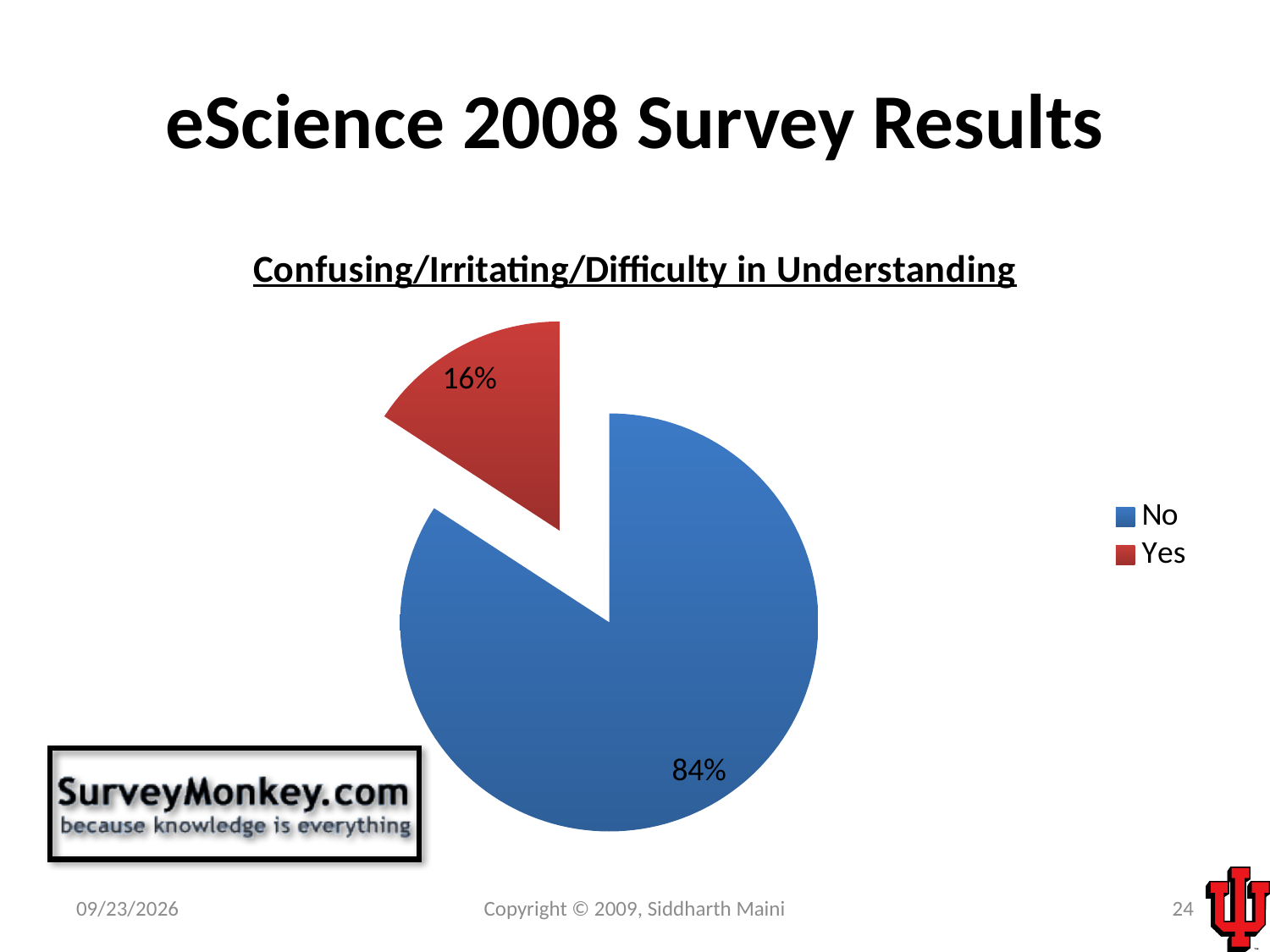
What percentage of the pie is labelled "Yes"? 16% How many categories does the legend list? 2 How many slices does the pie chart have? 2 What share of the pie does the "Yes" slice represent? 16% Which category has the largest share of the pie? No What colour is the "Yes" slice? red What percentage of the pie is labelled "No"? 84% Which category has the smallest share of the pie? Yes Which slice is larger, "No" or "Yes"? No What kind of chart is shown on the slide? pie chart What is the title of the chart? Confusing/Irritating/Difficulty in Understanding What is the difference in percentage points between the "No" and "Yes" slices? 68